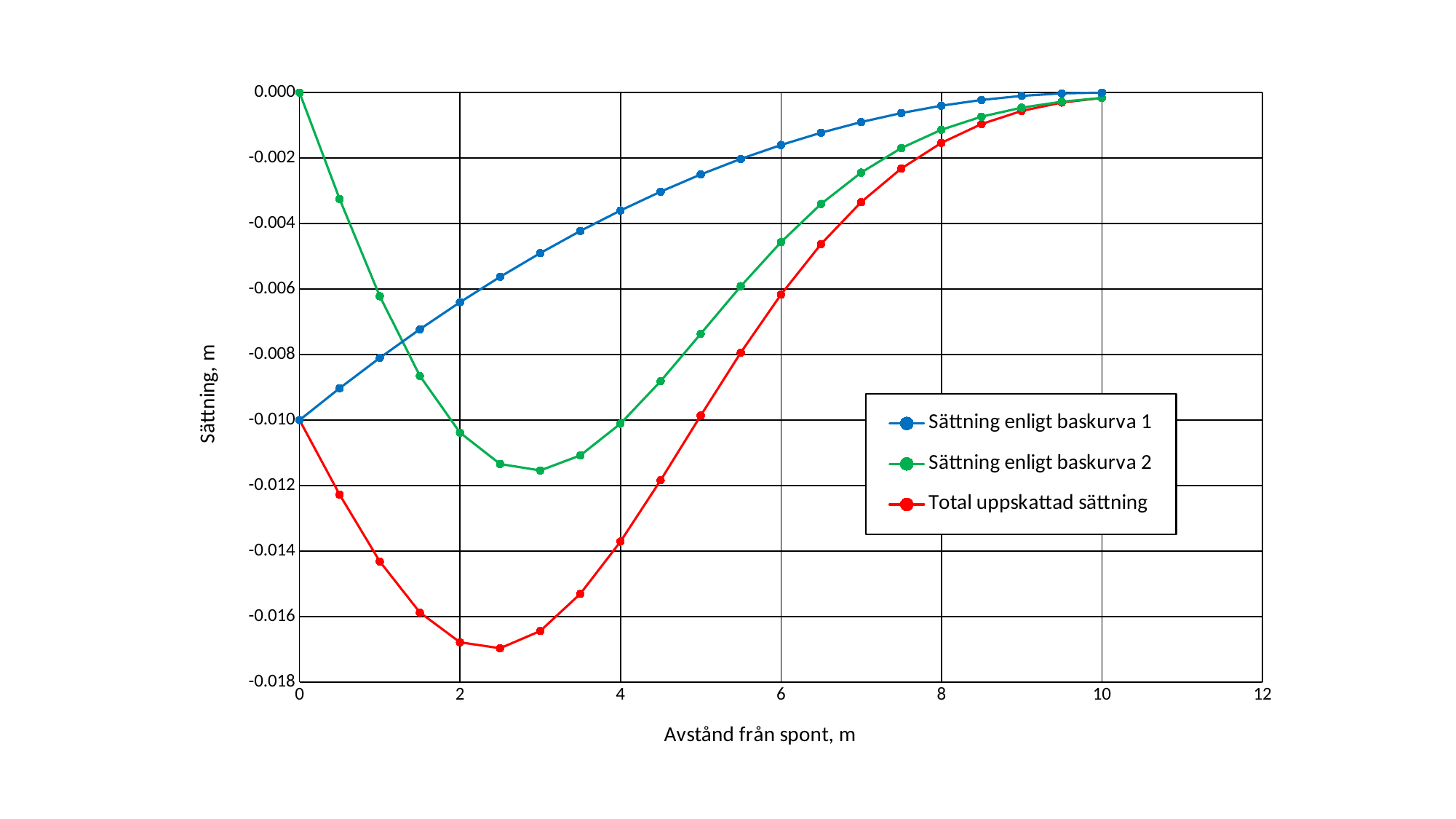
Is the value for Total uppskattad sättning at 2.5 m greater or less than -0.016? less What kind of chart is shown on the slide? line chart Is the value for Sättning enligt baskurva 1 at 6 m greater or less than -0.002? greater How many series does the legend list? 3 At a distance of 4 m, which series has the higher value: Sättning enligt baskurva 1 or Sättning enligt baskurva 2? Sättning enligt baskurva 1 Which series reaches the lowest value on the chart? Total uppskattad sättning Does Total uppskattad sättning rise or fall as the distance increases from 4 m to 10 m? rise What is the value of Sättning enligt baskurva 2 at a distance of 0 m? 0.000 What is the value of Sättning enligt baskurva 1 at a distance of 0 m? -0.010 How many data points are plotted for the Total uppskattad sättning series? 21 What is the title of the x axis? Avstånd från spont, m Is the value for Sättning enligt baskurva 2 at 3 m greater or less than -0.010? less